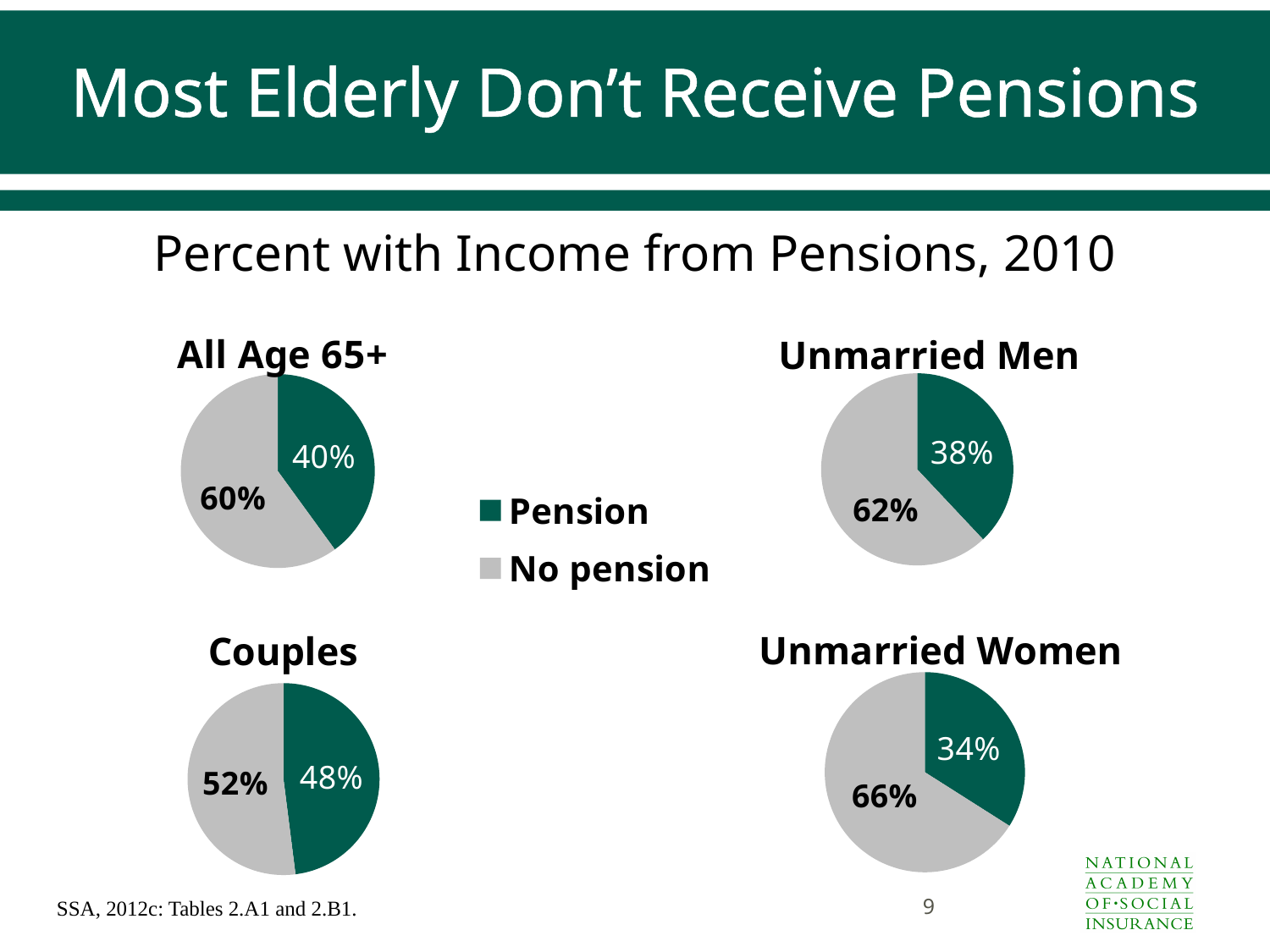
In the 'Couples' pie chart, what is the difference between the 'No pension' and 'Pension' shares? 4% Which colour represents 'No pension' in the pie charts? Gray What kind of chart is used for each of the four groups on the slide? Pie chart How many pie charts are shown on the slide? 4 Across the four pie charts, which group has the highest share with a pension? Couples In the 'Unmarried Men' pie chart, what percent have no pension? 62% In the 'All Age 65+' pie chart, what percent have a pension? 40% In the 'Couples' pie chart, what percent have a pension? 48% In the 'Unmarried Women' pie chart, what percent have no pension? 66% Is the 'Pension' share larger for Unmarried Men or for Unmarried Women? Unmarried Men How many entries does the legend list? 2 Across the four pie charts, which group has the lowest share with a pension? Unmarried Women